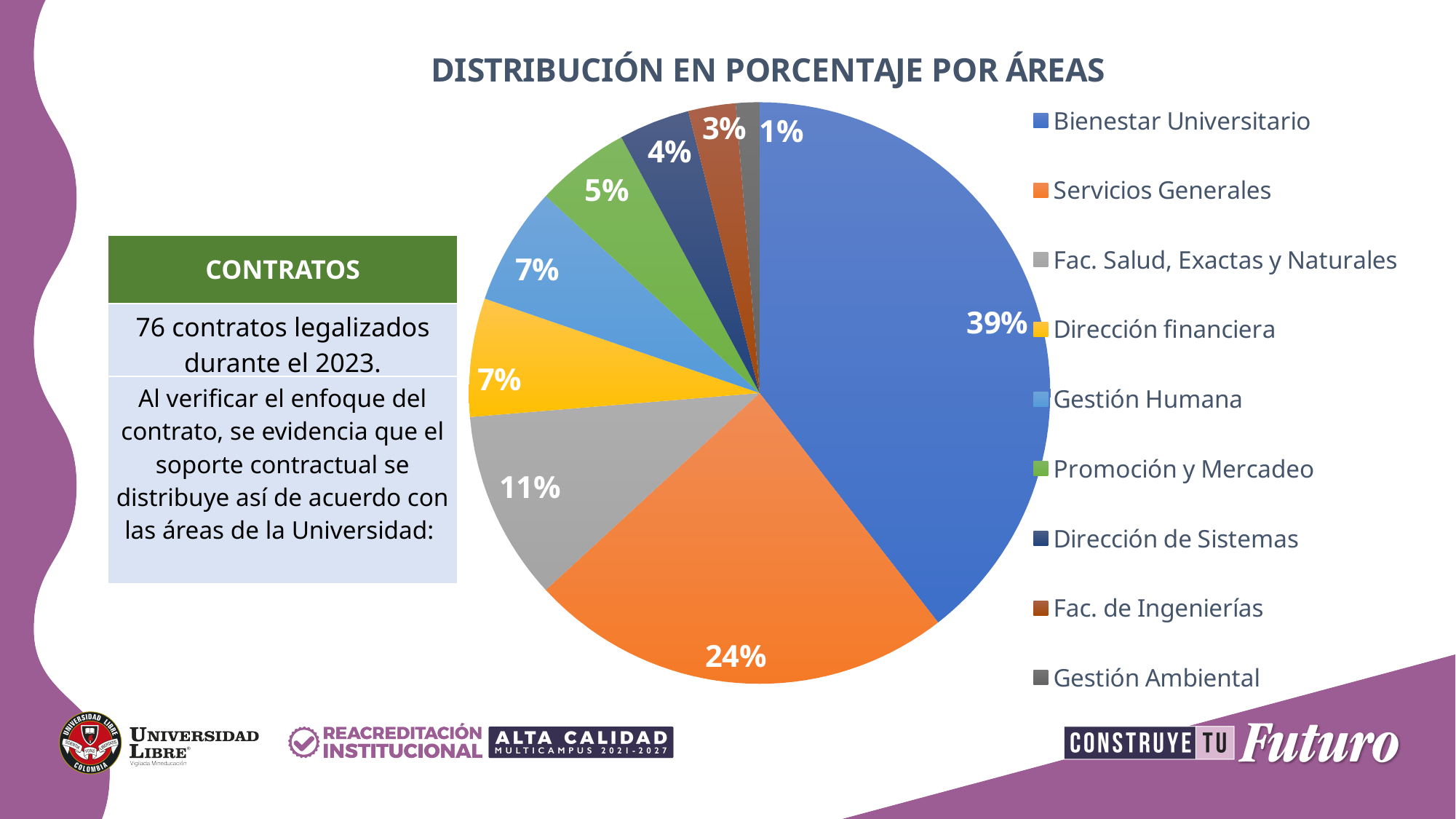
What percentage of the pie corresponds to Gestión Ambiental? 1% What is the difference in percentage points between Bienestar Universitario and Servicios Generales? 15 What percentage of the pie corresponds to Promoción y Mercadeo? 5% What is the title of the chart? DISTRIBUCIÓN EN PORCENTAJE POR ÁREAS Which has a larger share, Dirección de Sistemas or Fac. de Ingenierías? Dirección de Sistemas What percentage of the pie corresponds to Bienestar Universitario? 39% Which area has the largest share of the pie? Bienestar Universitario How many areas are listed in the chart legend? 9 Which area has the smallest share of the pie? Gestión Ambiental What kind of chart is shown on the slide? pie chart What percentage of the pie corresponds to Fac. Salud, Exactas y Naturales? 11% What percentage of the pie corresponds to Servicios Generales? 24%